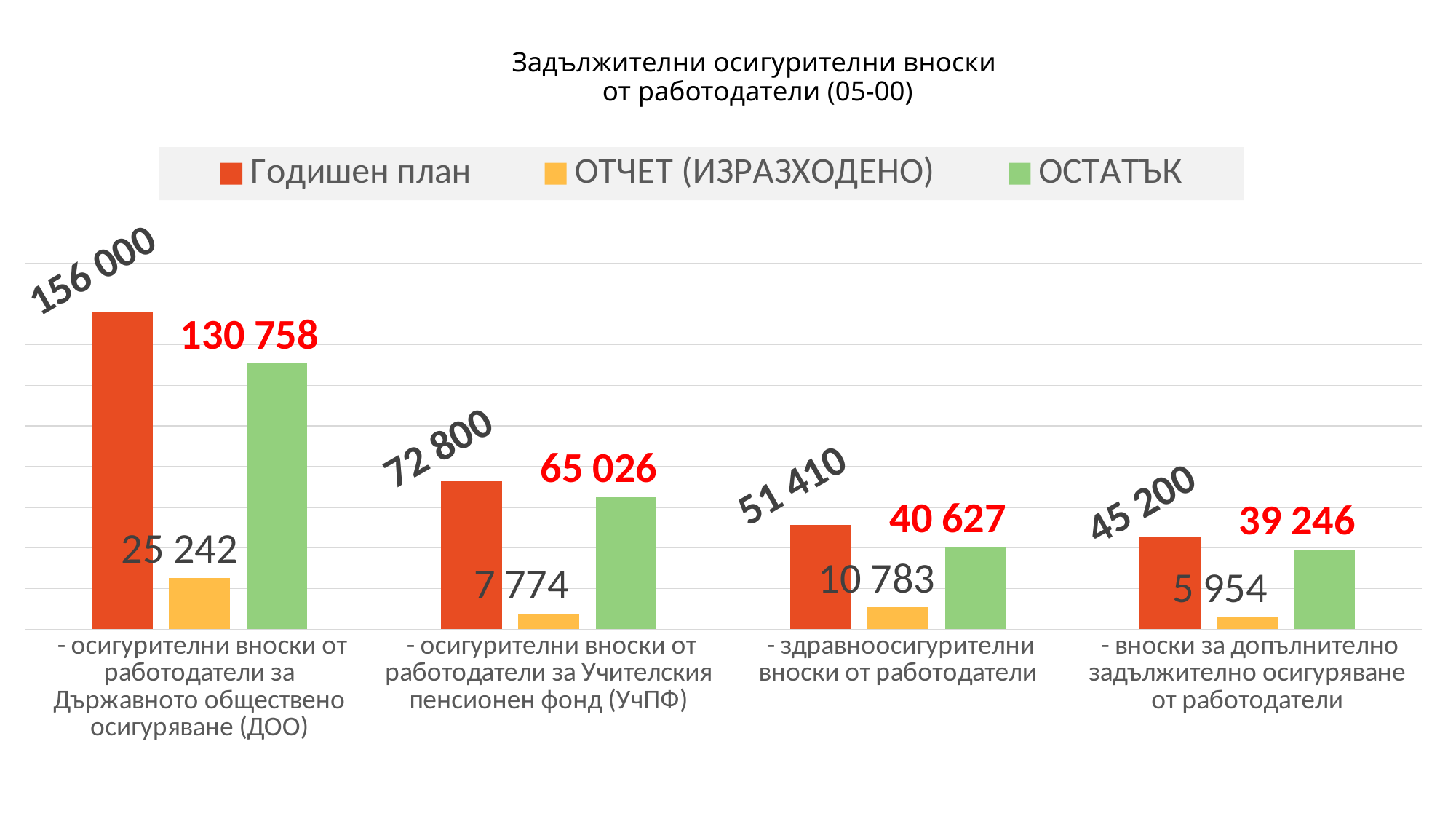
What is the Годишен план value for осигурителни вноски от работодатели за Държавното обществено осигуряване (ДОО)? 156 000 What is the title of the chart? Задължителни осигурителни вноски от работодатели (05-00) How many series does the legend list? 3 What is the ОТЧЕТ (ИЗРАЗХОДЕНО) value for осигурителни вноски от работодатели за Учителския пенсионен фонд (УчПФ)? 7 774 Which is larger: the ОСТАТЪК for здравноосигурителни вноски от работодатели or the ОСТАТЪК for вноски за допълнително задължително осигуряване от работодатели? здравноосигурителни вноски от работодатели Which category has the lowest ОТЧЕТ (ИЗРАЗХОДЕНО) value? вноски за допълнително задължително осигуряване от работодатели What is the ОСТАТЪК value for здравноосигурителни вноски от работодатели? 40 627 What is the ОТЧЕТ (ИЗРАЗХОДЕНО) value for вноски за допълнително задължително осигуряване от работодатели? 5 954 Which category has the highest Годишен план value? осигурителни вноски от работодатели за Държавното обществено осигуряване (ДОО) What type of chart is shown on the slide? bar chart How many categories are shown on the x axis? 4 What is the difference between the Годишен план values for ДОО and for Учителския пенсионен фонд (УчПФ)? 83 200